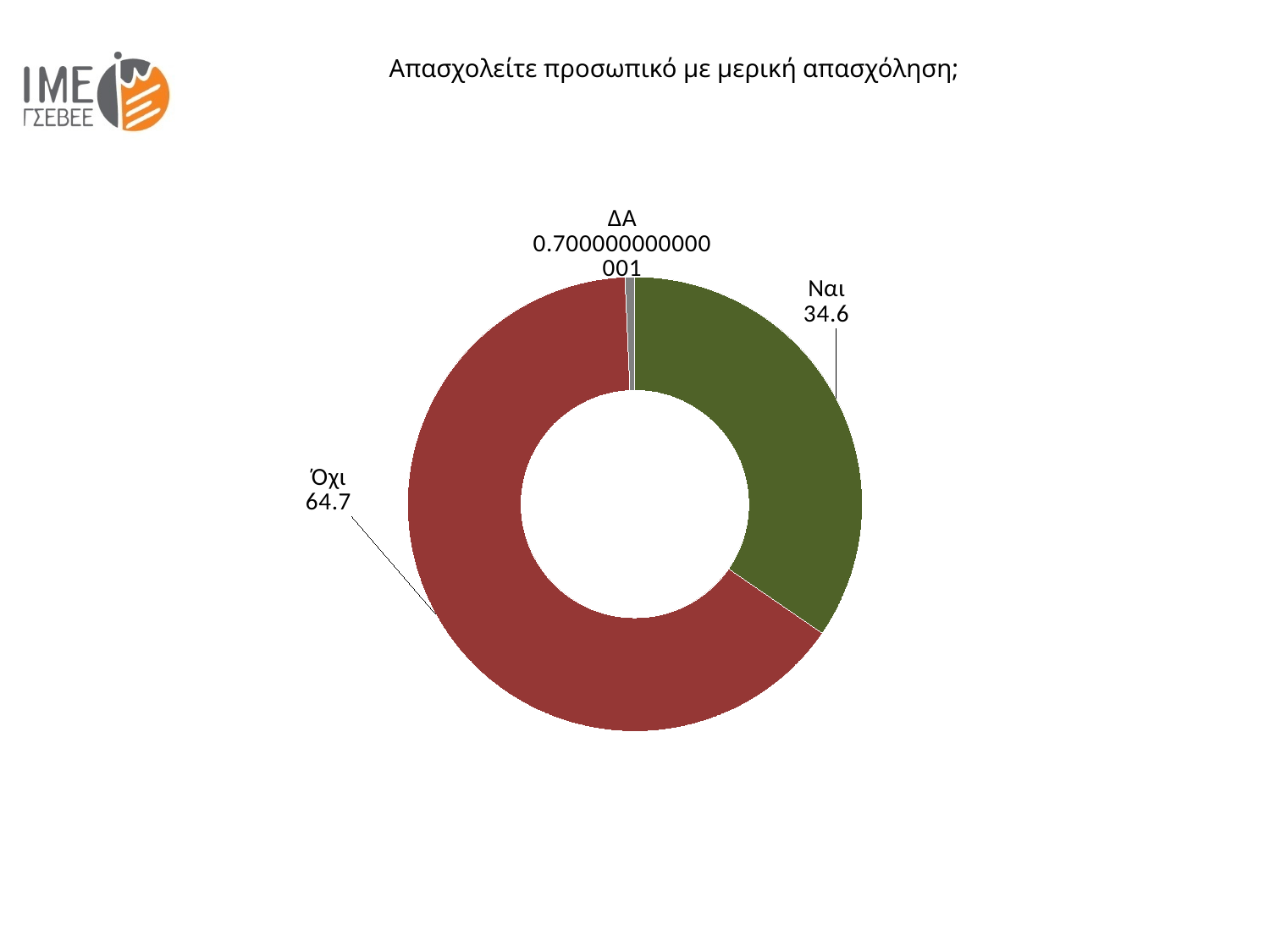
What kind of chart is shown on the slide? doughnut chart What is the value for Ναι? 34.6 What value is shown for ΔΑ? 0.700000000000001 What is the title of the chart? Απασχολείτε προσωπικό με μερική απασχόληση; Which is larger, the value for Ναι or the value for Όχι? Όχι Which category has the smallest slice? ΔΑ Which category has the largest slice? Όχι What is the difference between the values for Όχι and Ναι? 30.1 What colour is the slice for Ναι? green How many categories are shown in the chart? 3 What is the value for Όχι? 64.7